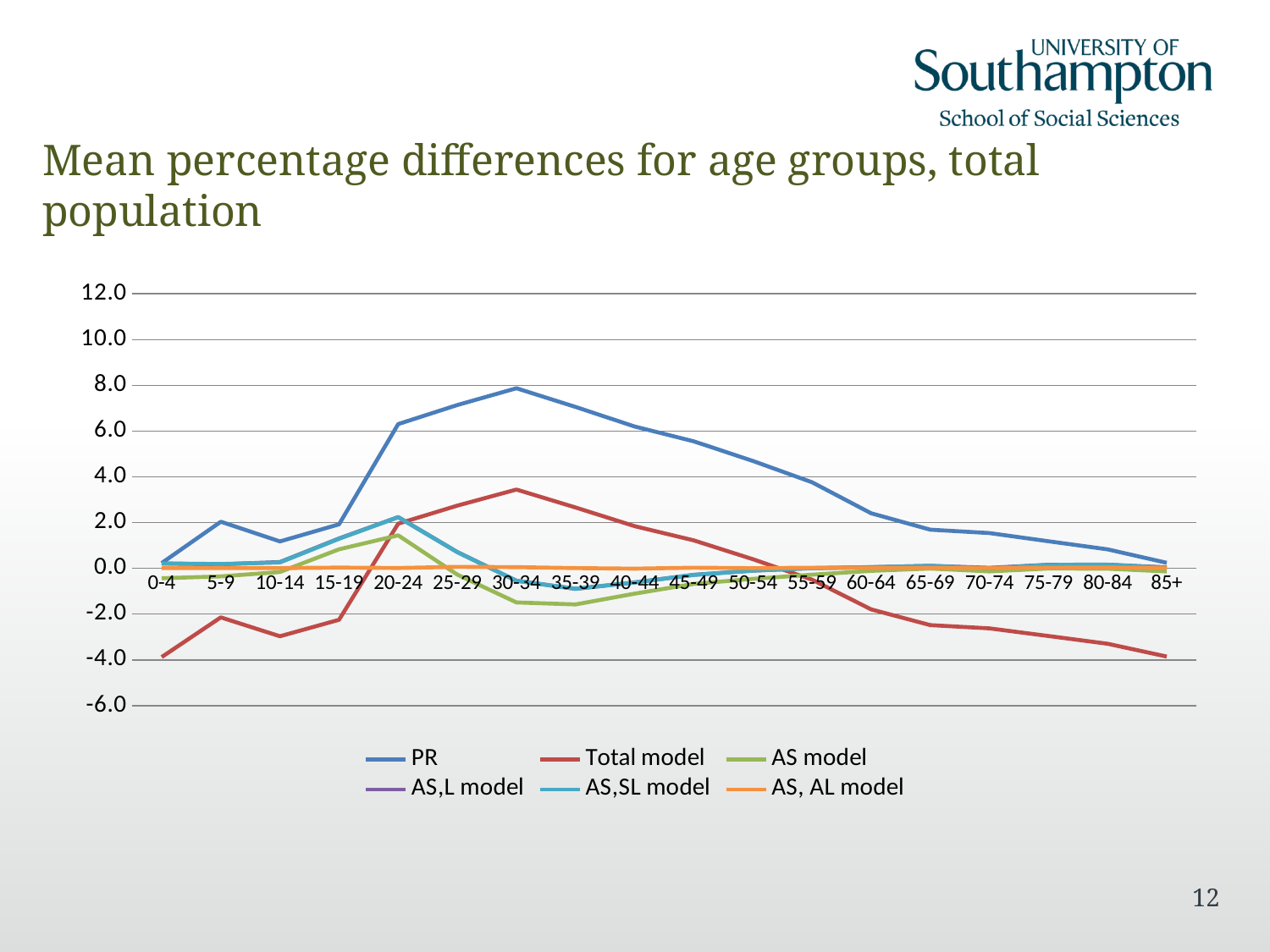
How many series does the legend list? 6 What kind of chart is shown on the slide? line chart Is the value of the Total model series at 0-4 greater or less than -2.0? less Which series has the higher value at 30-34, PR or Total model? PR Does the PR series rise or fall from 30-34 to 85+? fall Is the value of the Total model series at 30-34 greater or less than 2.0? greater At which age group does the PR series reach its highest value? 30-34 How many age group categories are shown on the x axis? 18 Is the value of the AS model series at 35-39 greater or less than 0.0? less What is the title of the slide? Mean percentage differences for age groups, total population Which series has the lowest value at the 0-4 age group? Total model